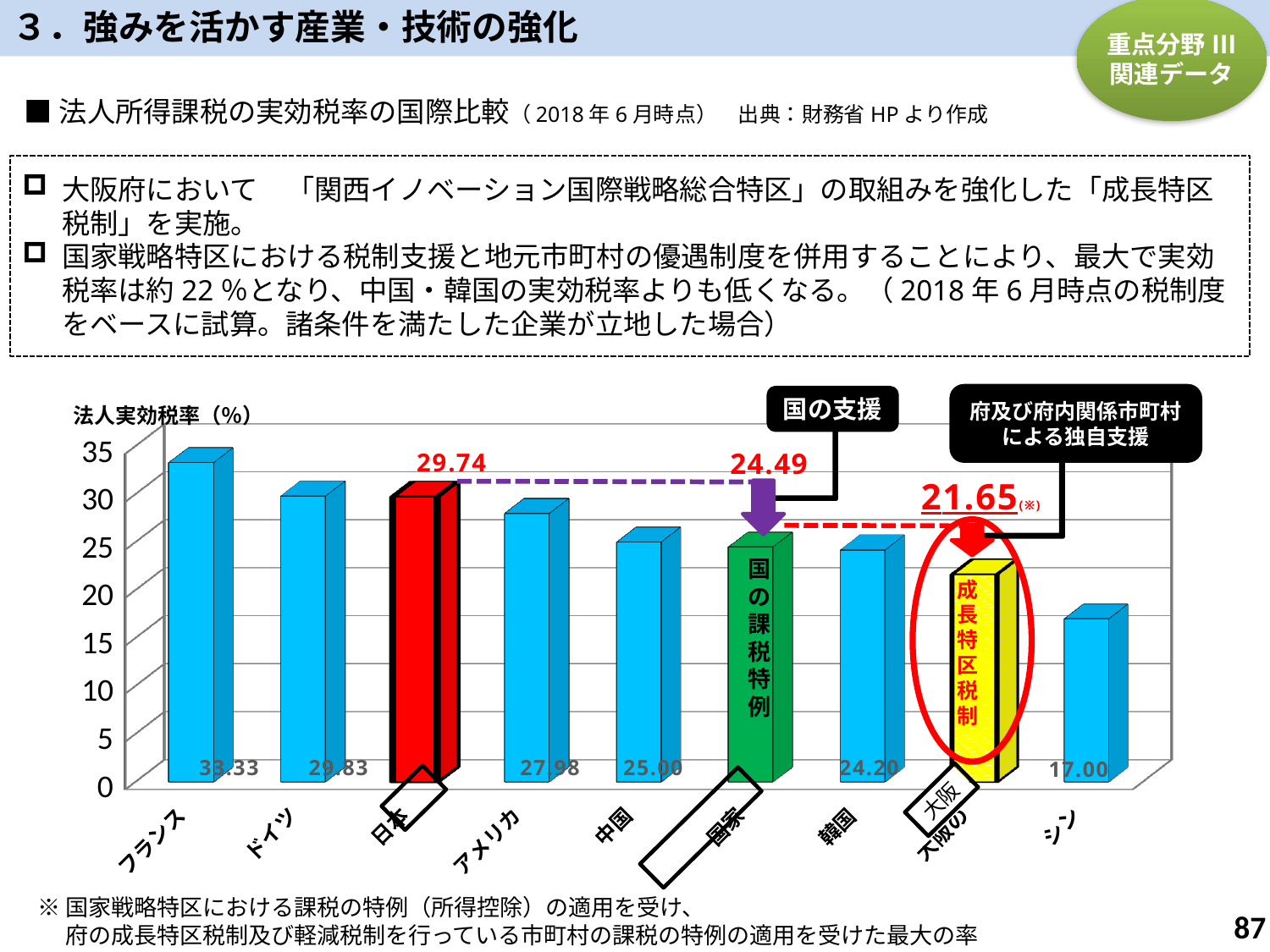
What is the lowest value shown in the chart? 17.00 Which is larger, the value for ドイツ or the value for 日本? ドイツ What is the difference between the values for 日本 and 韓国? 5.54 What kind of chart is shown? bar chart What is the value for 日本? 29.74 Which category has the highest value? フランス What is the value for the yellow bar labelled 成長特区税制? 21.65 Is the value for アメリカ greater or less than 25? greater What is the value for 韓国? 24.20 What is the value for フランス? 33.33 How many bars are shown in the chart? 9 What is the label on the vertical axis of the chart? 法人実効税率（%）